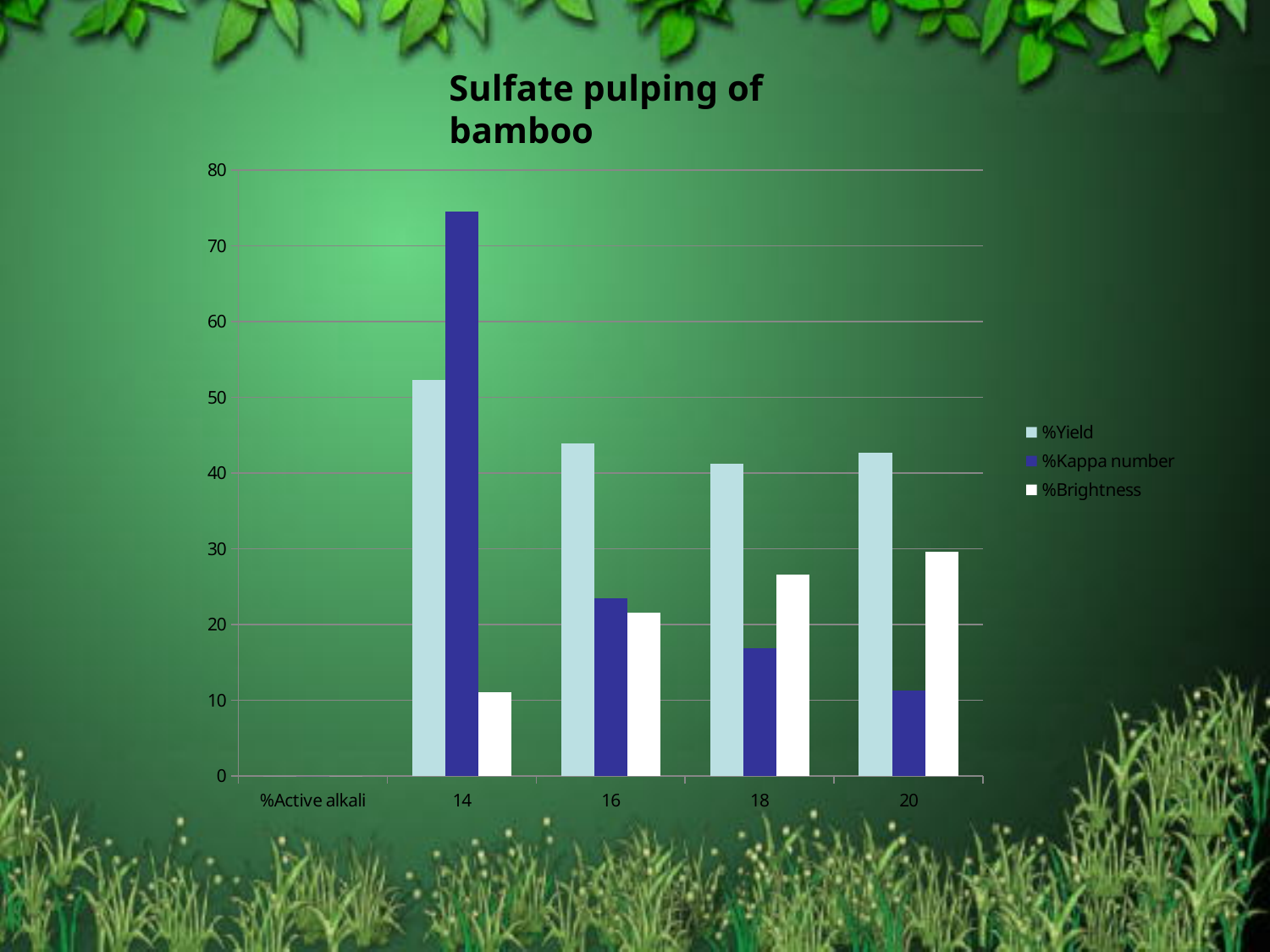
Which series are listed in the legend? %Yield, %Kappa number, %Brightness Is the %Brightness at active alkali 14 greater or less than 20? less At active alkali 18, which is larger: %Brightness or %Kappa number? %Brightness How many series does the legend list? 3 Is the %Kappa number at active alkali 14 greater or less than 70? greater What kind of chart is shown on the slide? bar chart What is the title of the chart? Sulfate pulping of bamboo At which active alkali level is the %Brightness lowest? 14 Is the %Yield at active alkali 16 greater or less than 40? greater At which active alkali level is the %Brightness highest? 20 At which active alkali level is the %Kappa number highest? 14 Does the %Kappa number rise or fall as active alkali increases from 14 to 20? fall